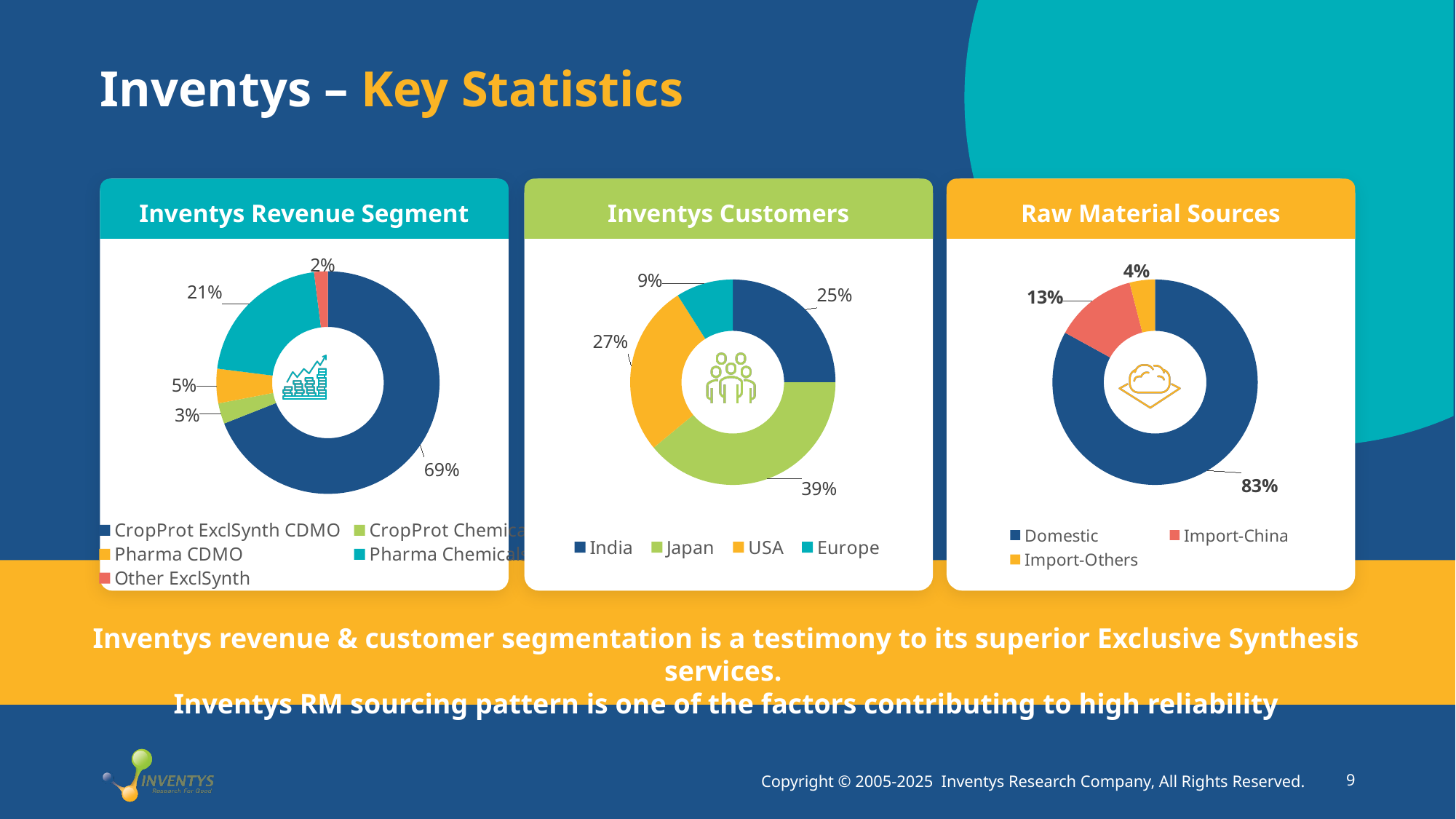
In the Raw Material Sources chart, which source has the smallest share? Import-Others In the Inventys Customers chart, what is the difference between the USA share and the India share? 2% How many categories does the legend of the Raw Material Sources chart list? 3 In the Raw Material Sources chart, what percentage is Import-China? 13% In the Inventys Customers chart, what share of customers is from Europe? 9% In the Inventys Revenue Segment chart, what share does CropProt ExclSynth CDMO account for? 69% In the Inventys Customers chart, which is larger, the share for USA or the share for Europe? USA In the Inventys Customers chart, what share of customers is from Japan? 39% In the Inventys Customers chart, which region has the largest share? Japan In the Raw Material Sources chart, what percentage is Domestic? 83% What kind of chart is the Inventys Customers chart? Donut (pie) chart In the Inventys Revenue Segment chart, what share does Pharma CDMO account for? 5%